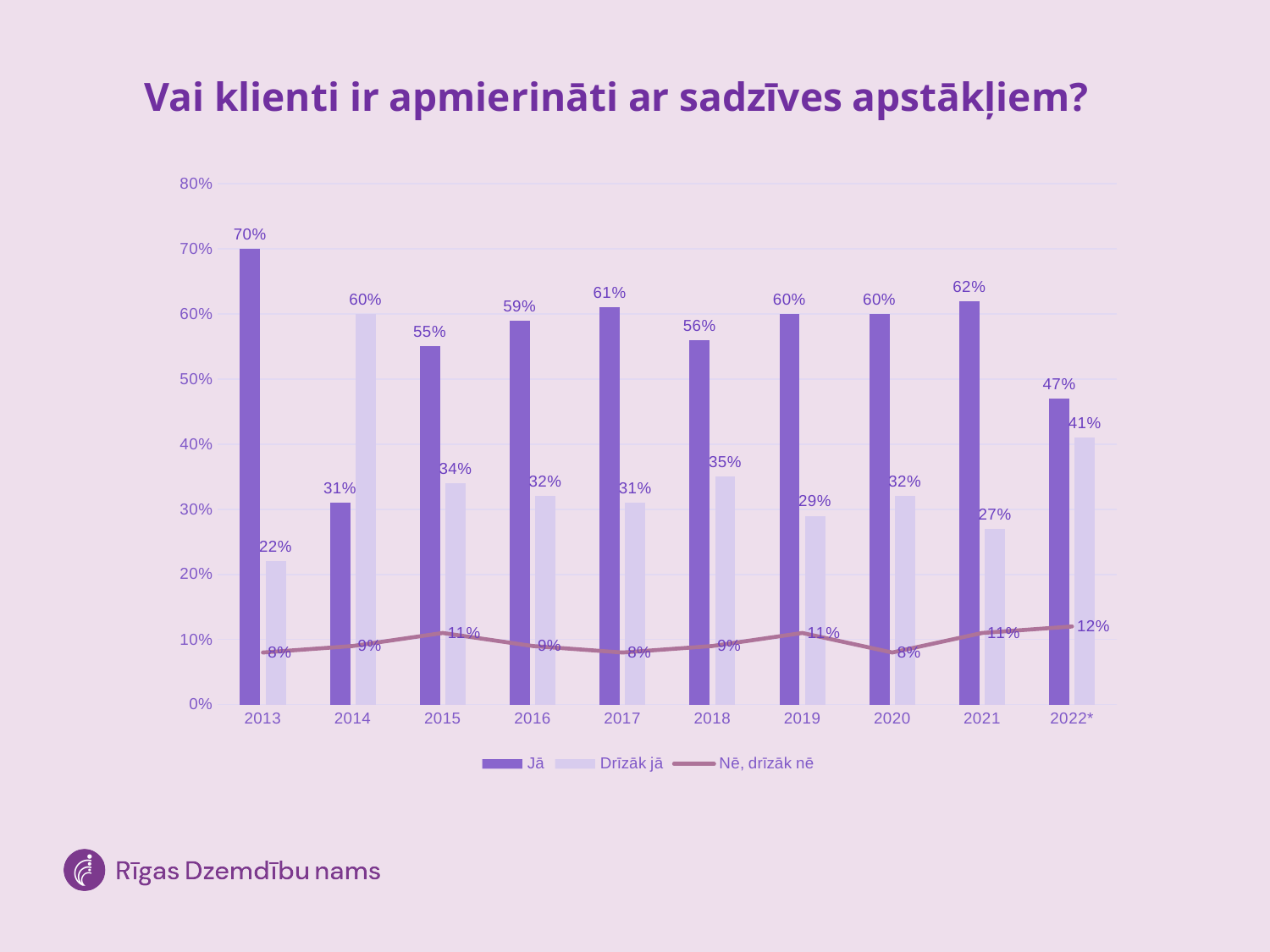
What is the title of the chart? Vai klienti ir apmierināti ar sadzīves apstākļiem? In which year is the "Jā" value the highest? 2013 Which is larger in 2018: the "Jā" value or the "Drīzāk jā" value? Jā How many series does the legend list? 3 What kind of chart is shown on the slide? Combined bar and line chart How many years are shown on the x axis? 10 What is the value for "Drīzāk jā" in 2014? 60% In which year is the "Jā" value the lowest? 2014 What is the value for "Nē, drīzāk nē" in 2022*? 12% What is the difference between the "Jā" values for 2021 and 2022*? 15% Is the "Drīzāk jā" value for 2022* greater or less than 40%? greater What is the value for "Jā" in 2013? 70%